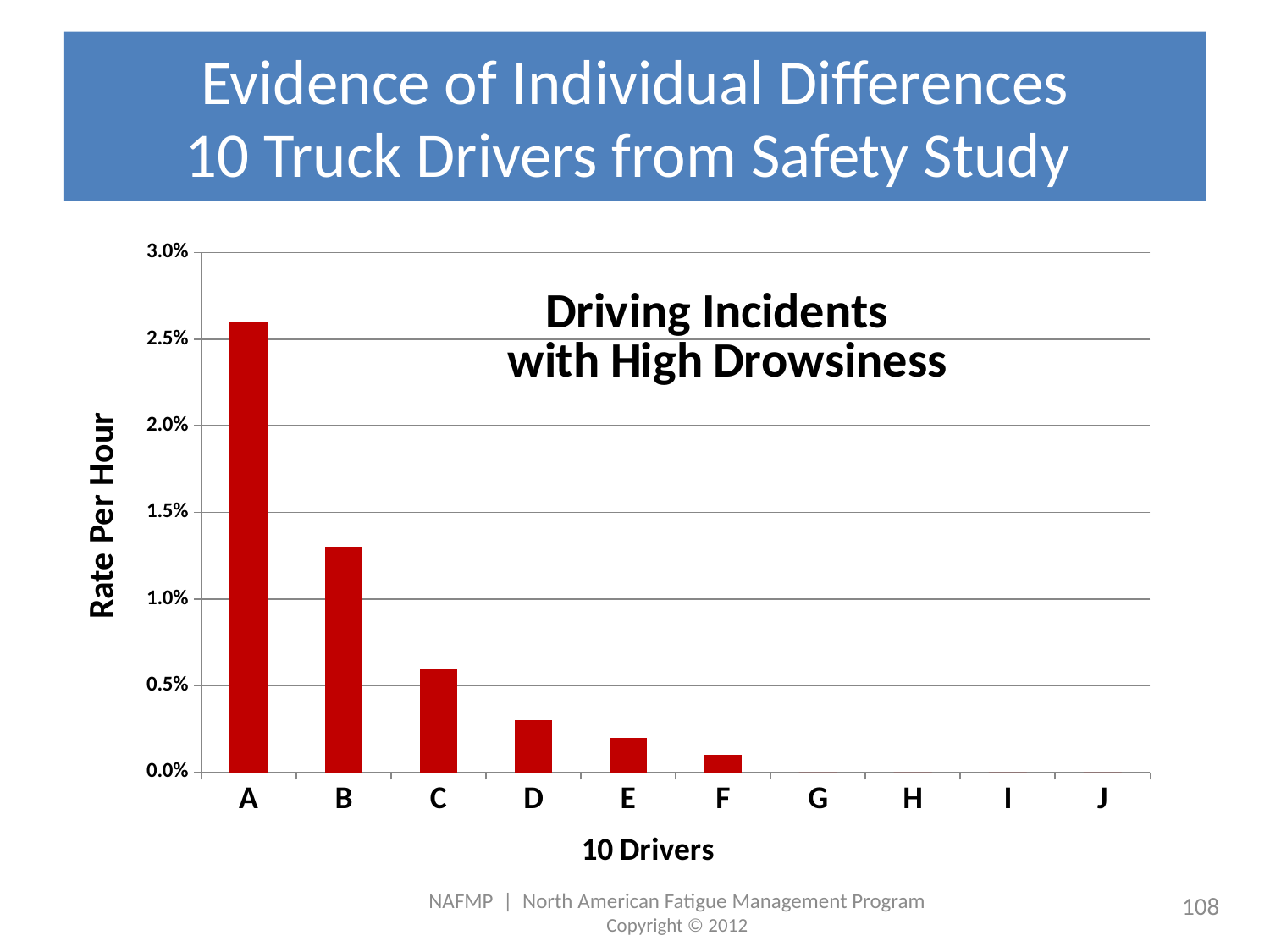
What kind of chart is shown on the slide? bar chart How many drivers are shown on the x axis of the chart? 10 Is the rate per hour for driver D greater or less than 0.5%? less Is the rate per hour for driver A greater or less than 2.5%? greater Which driver has the highest rate of driving incidents with high drowsiness? A What is the title shown inside the chart area? Driving Incidents with High Drowsiness Is the rate per hour for driver C greater or less than 0.5%? greater Which driver has a higher rate per hour, C or D? C Do the rates per hour rise or fall moving from driver A to driver J along the x axis? fall What is the label on the y axis of the chart? Rate Per Hour